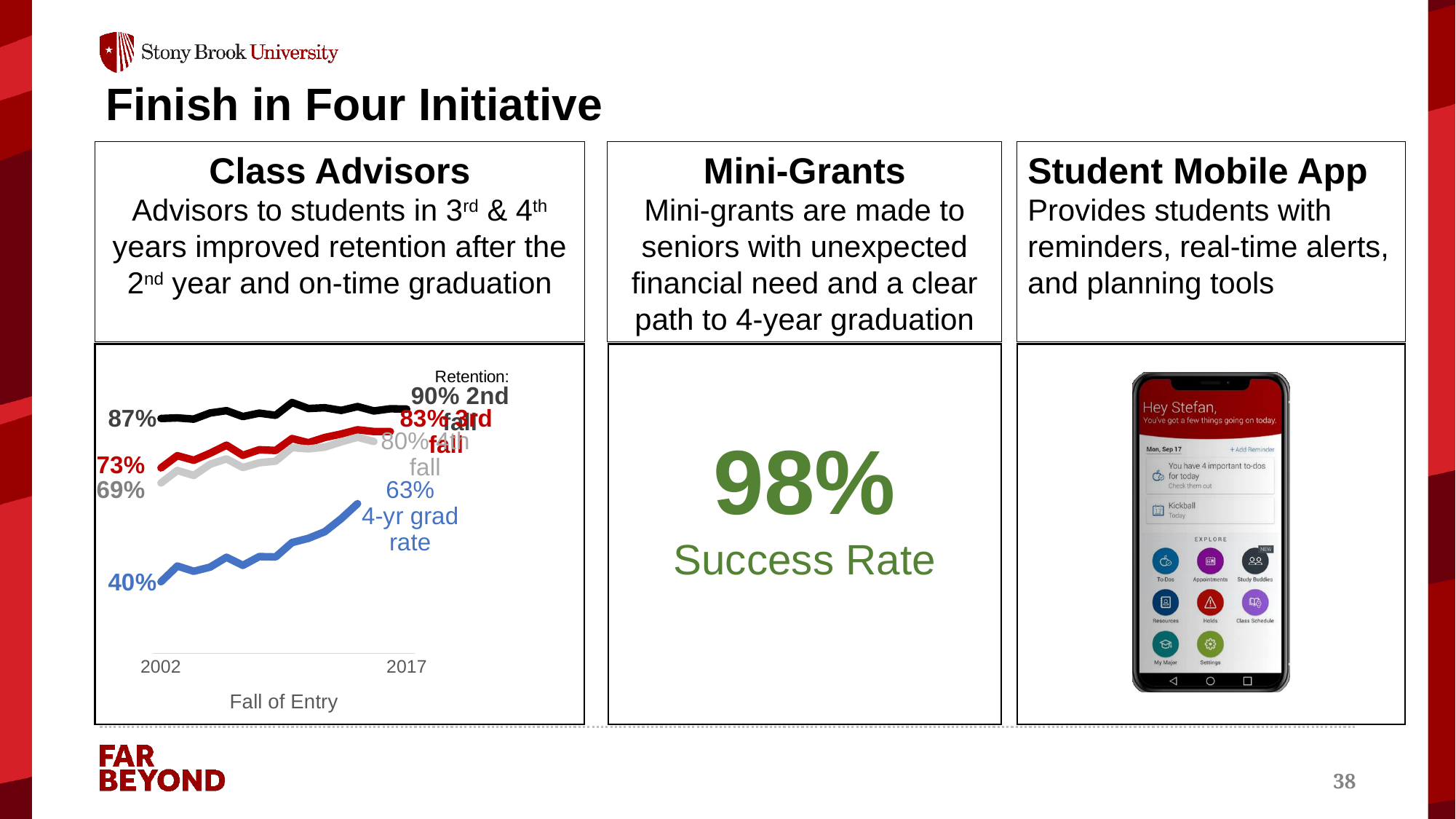
What type of chart is shown in the Class Advisors panel? line chart In the Class Advisors chart, does the 4-yr grad rate rise or fall from 2002 to 2017? rise In the Class Advisors chart, what was the 2nd fall retention rate for the 2002 fall of entry cohort? 87% In the Class Advisors chart, what was the 4-yr grad rate for the 2002 cohort? 40% In the Class Advisors chart, what was the 3rd fall retention rate for the 2002 cohort? 73% In the Class Advisors chart, which line has the lowest values across the whole period? 4-yr grad rate In the Class Advisors chart, what was the 2nd fall retention rate for the 2017 fall of entry cohort? 90% What is the x-axis label of the Class Advisors chart? Fall of Entry